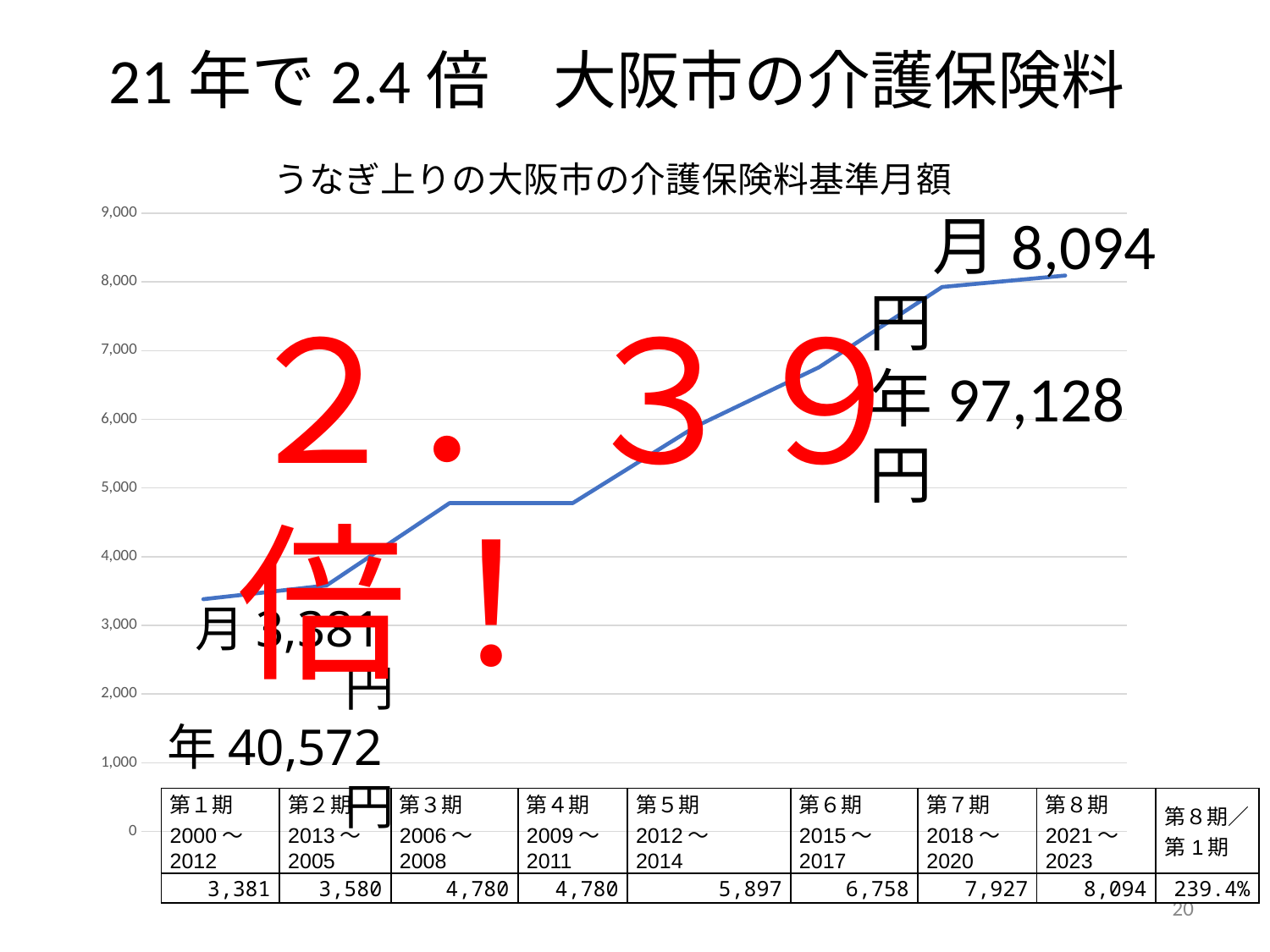
What is the value for 第５期 (2012～2014)? 5,897 How many periods are plotted on the chart? 8 Do the values rise or fall from 第１期 to 第８期? rise What is the value for 第１期 (2000～2012)? 3,381 Which period has the lowest value? 第１期 Which period has the highest value? 第８期 Is the value for 第７期 greater or less than 7,000? greater What is the value for 第８期 (2021～2023)? 8,094 What kind of chart is shown on the slide? line chart What is the title of the chart? うなぎ上りの大阪市の介護保険料基準月額 Which is larger, the value for 第６期 or the value for 第７期? 第７期 What is the difference between the values for 第８期 and 第１期? 4,713